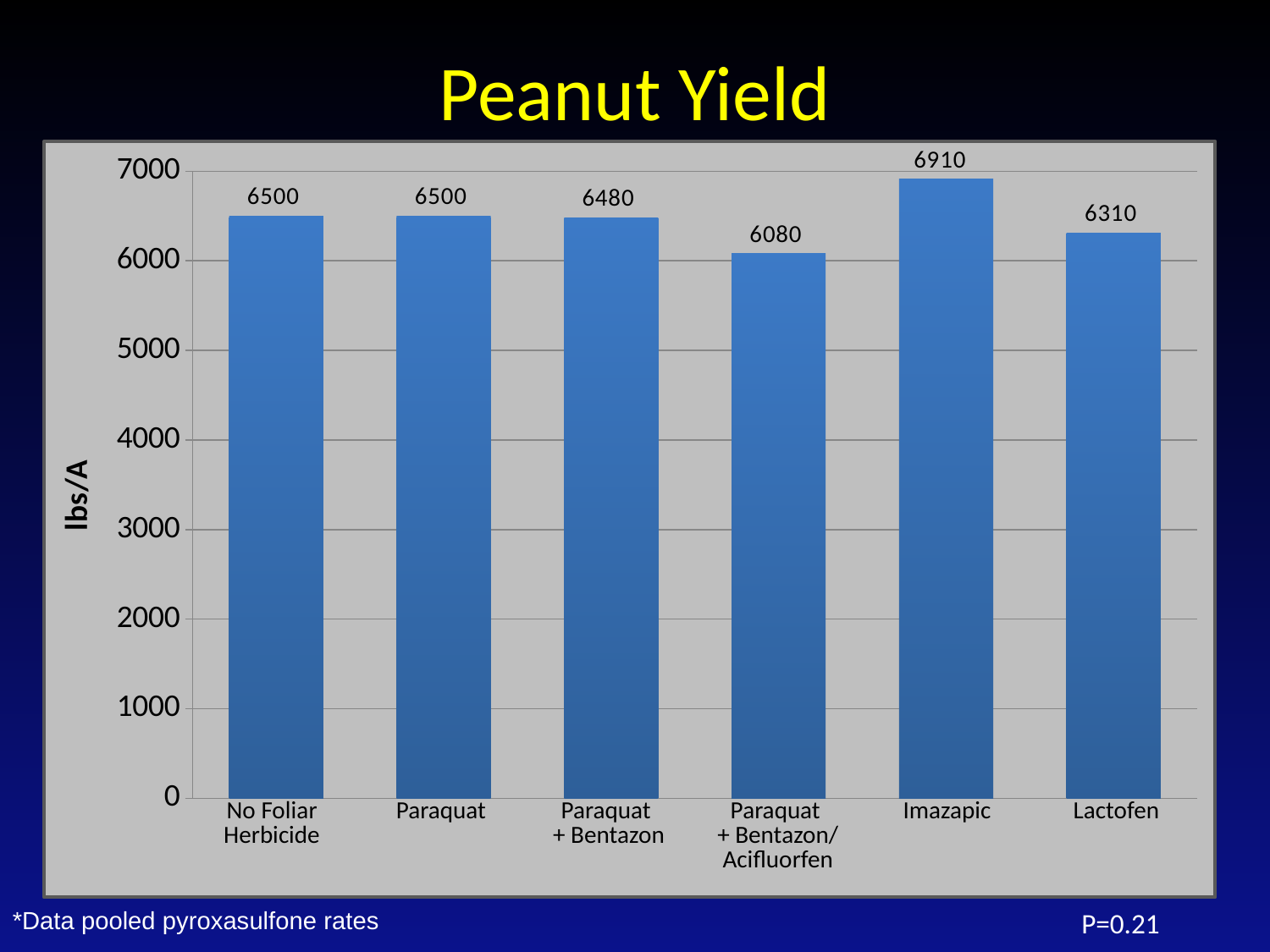
Which treatment has the highest peanut yield? Imazapic Which has a higher peanut yield, Lactofen or Paraquat + Bentazon? Paraquat + Bentazon Which treatment has the lowest peanut yield? Paraquat + Bentazon/Acifluorfen What is the label on the vertical axis of the chart? lbs/A What kind of chart is shown on the slide? Bar chart What is the difference in peanut yield between Imazapic and Lactofen? 600 How many treatments are shown in the chart? 6 What is the difference in peanut yield between Paraquat and Paraquat + Bentazon/Acifluorfen? 420 What is the peanut yield for Lactofen? 6310 What is the peanut yield for No Foliar Herbicide? 6500 What is the peanut yield for Imazapic? 6910 What is the peanut yield for Paraquat + Bentazon/Acifluorfen? 6080